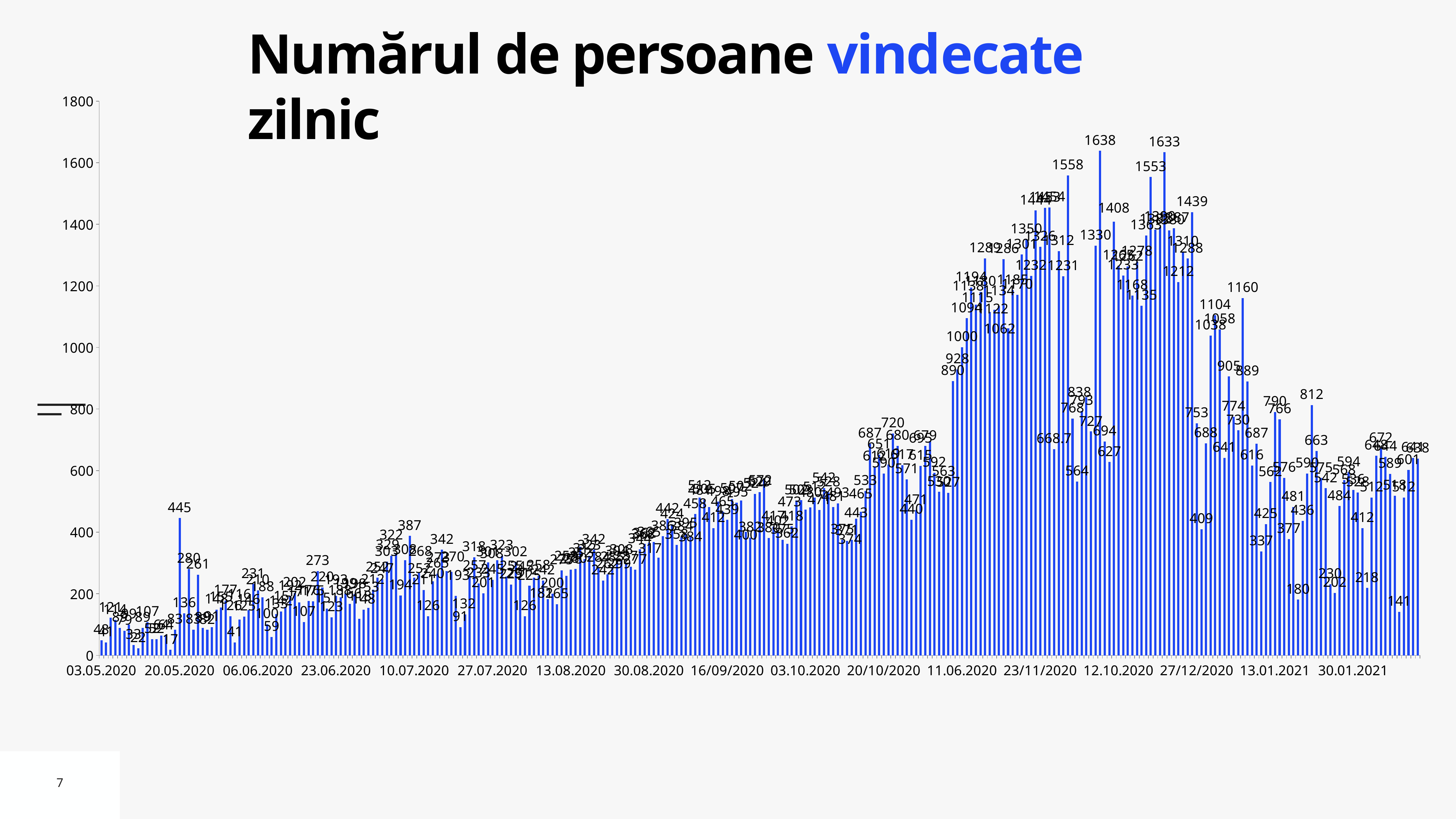
What is the lowest value labelled on the chart, near 20.05.2020? 17 Which is larger, the peak labelled 1638 or the peak labelled 1558? 1638 What is the difference between the two highest labelled values, 1638 and 1633? 5 What is the highest value labelled in May 2020, the spike just after 20.05.2020? 445 What is the highest daily value labelled on the chart? 1638 What kind of chart is shown on the slide? bar chart What is the first date label on the horizontal axis? 03.05.2020 What is the second-highest value labelled on the chart, appearing after the 1638 peak? 1633 Is the highest bar on the chart greater or less than 1600? greater Overall, do the daily values rise or fall from May 2020 to November 2020? rise What is the maximum value shown on the vertical axis? 1800 What is the title of the chart? Numărul de persoane vindecate zilnic